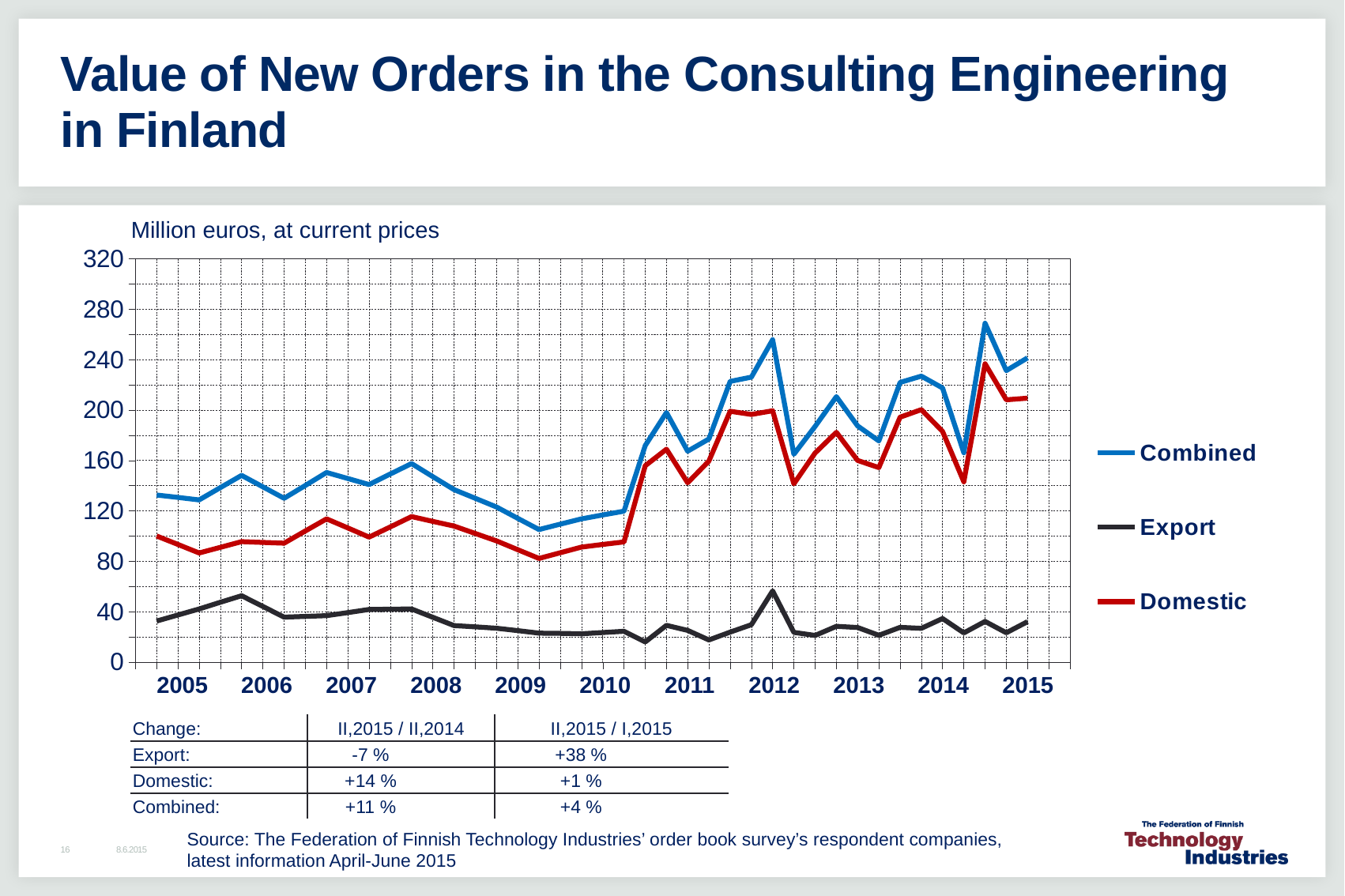
What unit is stated above the chart? Million euros, at current prices Is the value of the Domestic series in 2009 greater or less than 120? less Which series are listed in the legend? Combined, Export, Domestic Is the peak value of the Export series in 2012 greater or less than 40? greater What kind of chart is shown on the slide? line chart Is the peak value of the Combined series in 2014 greater or less than 240? greater In 2012, which is larger, the Domestic series or the Export series? Domestic How many years are labelled on the x axis? 11 How many series does the legend list? 3 Does the Combined series overall rise or fall from 2005 to 2015? rise Which series has the lowest values throughout the chart? Export Which series has the highest values throughout the chart? Combined